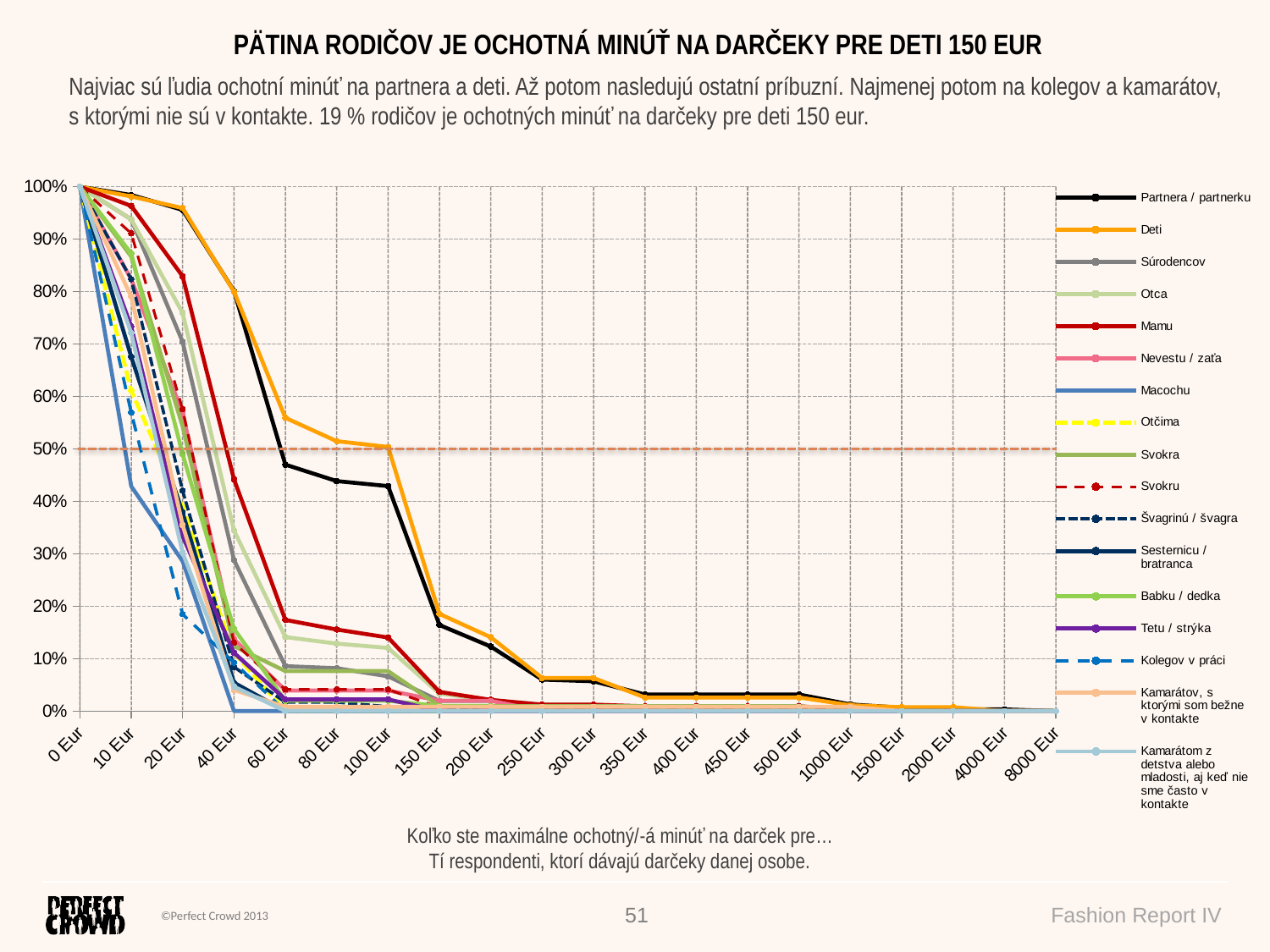
At 60 Eur, which is higher: Deti or Partnera / partnerku? Deti What kind of chart is shown on the slide? line chart At what percentage is the horizontal dashed reference line drawn? 50% What is the value for Deti at 0 Eur? 100% How many series does the legend list? 17 Do the values rise or fall as the amount on the x axis increases? fall Which series has the highest value at 60 Eur? Deti Is the value for Macochu at 10 Eur greater or less than 50%? less Is the value for Deti at 20 Eur greater or less than 90%? greater Is the value for Deti at 60 Eur greater or less than 50%? greater How many categories are shown on the x axis? 20